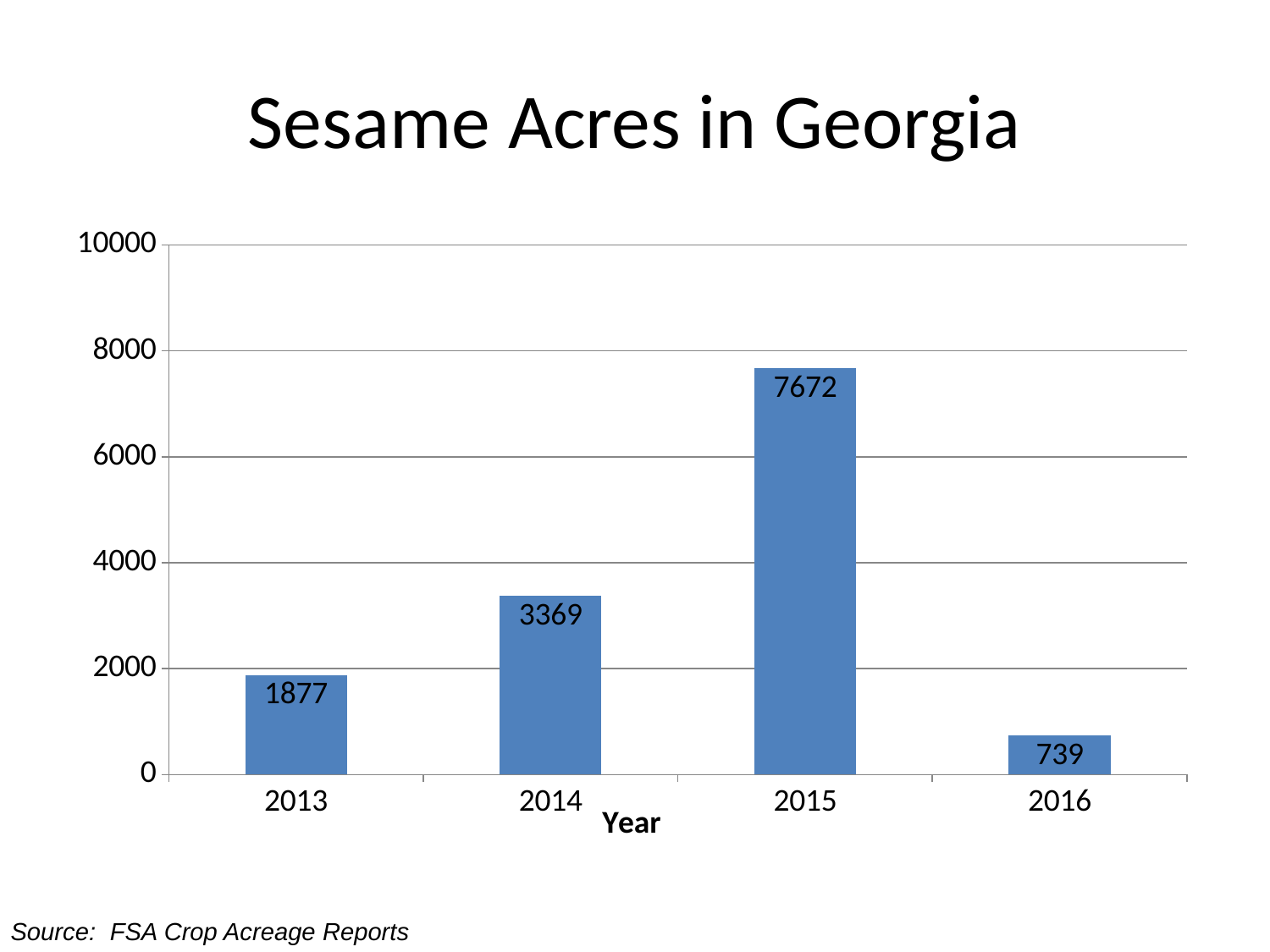
Which year has the highest value? 2015 What is the value for 2015? 7672 What is the value for 2013? 1877 Which year has the lowest value? 2016 What kind of chart is this? bar chart What is the difference between the values for 2013 and 2016? 1138 How many years are shown on the x axis? 4 Is the value for 2014 greater or less than 4000? less Which is larger, the value for 2014 or the value for 2013? 2014 What is the value for 2016? 739 What is the difference between the values for 2015 and 2014? 4303 What is the title of the chart? Sesame Acres in Georgia